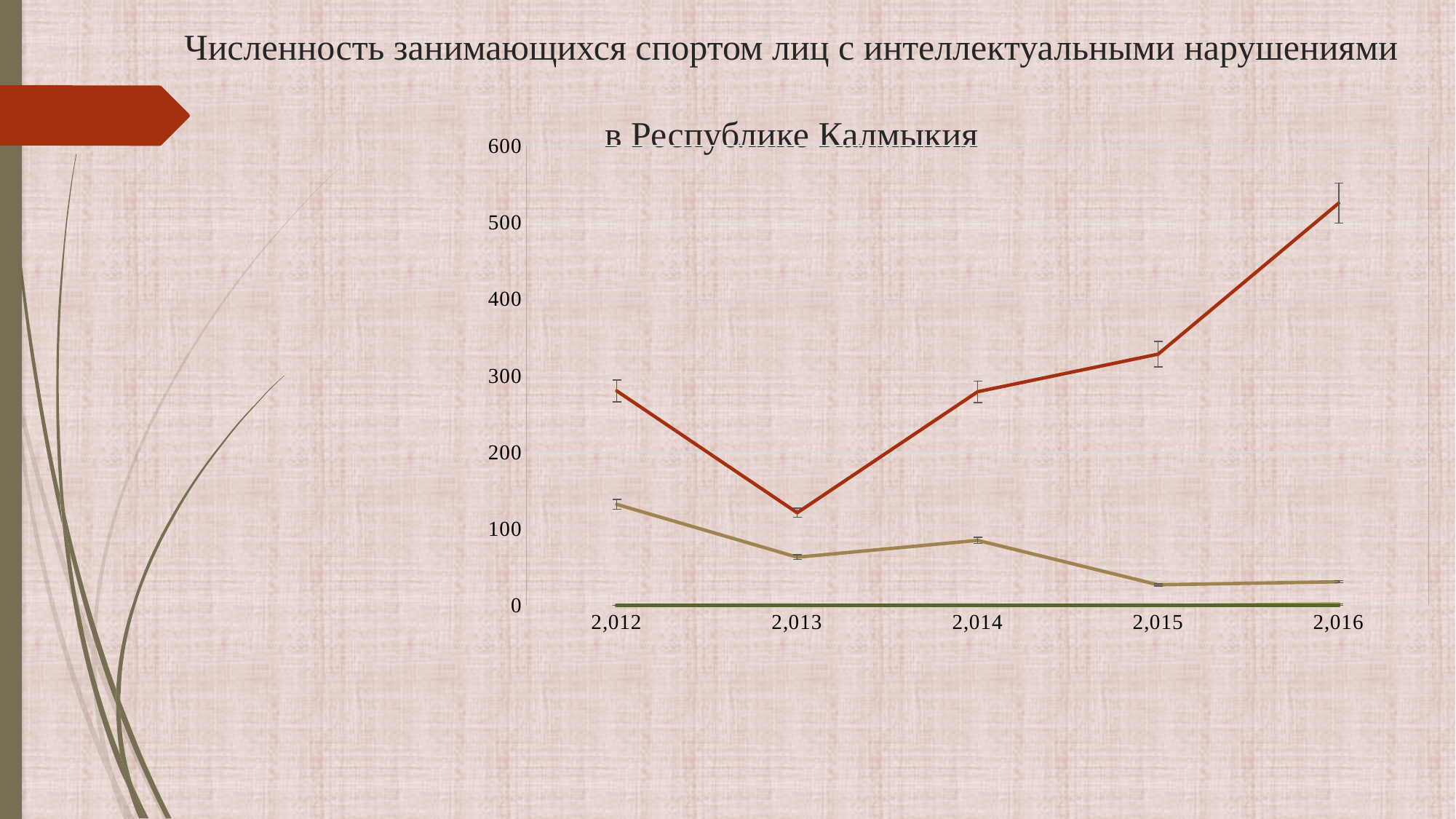
What kind of chart is shown on the slide? line chart Is the value of the tan (light brown) line for 2,012 greater or less than 100? greater Is the value of the tan (light brown) line for 2,015 greater or less than 100? less How many years are plotted along the x axis? 5 In which year does the red line reach its highest value? 2,016 Does the red line rise or fall between 2,013 and 2,016? rises Is the value of the red line for 2,016 greater or less than 500? greater At 2,014, which line has the larger value, the red line or the tan line? the red line In which year does the tan (light brown) line reach its highest value? 2,012 In which year does the red line reach its lowest value? 2,013